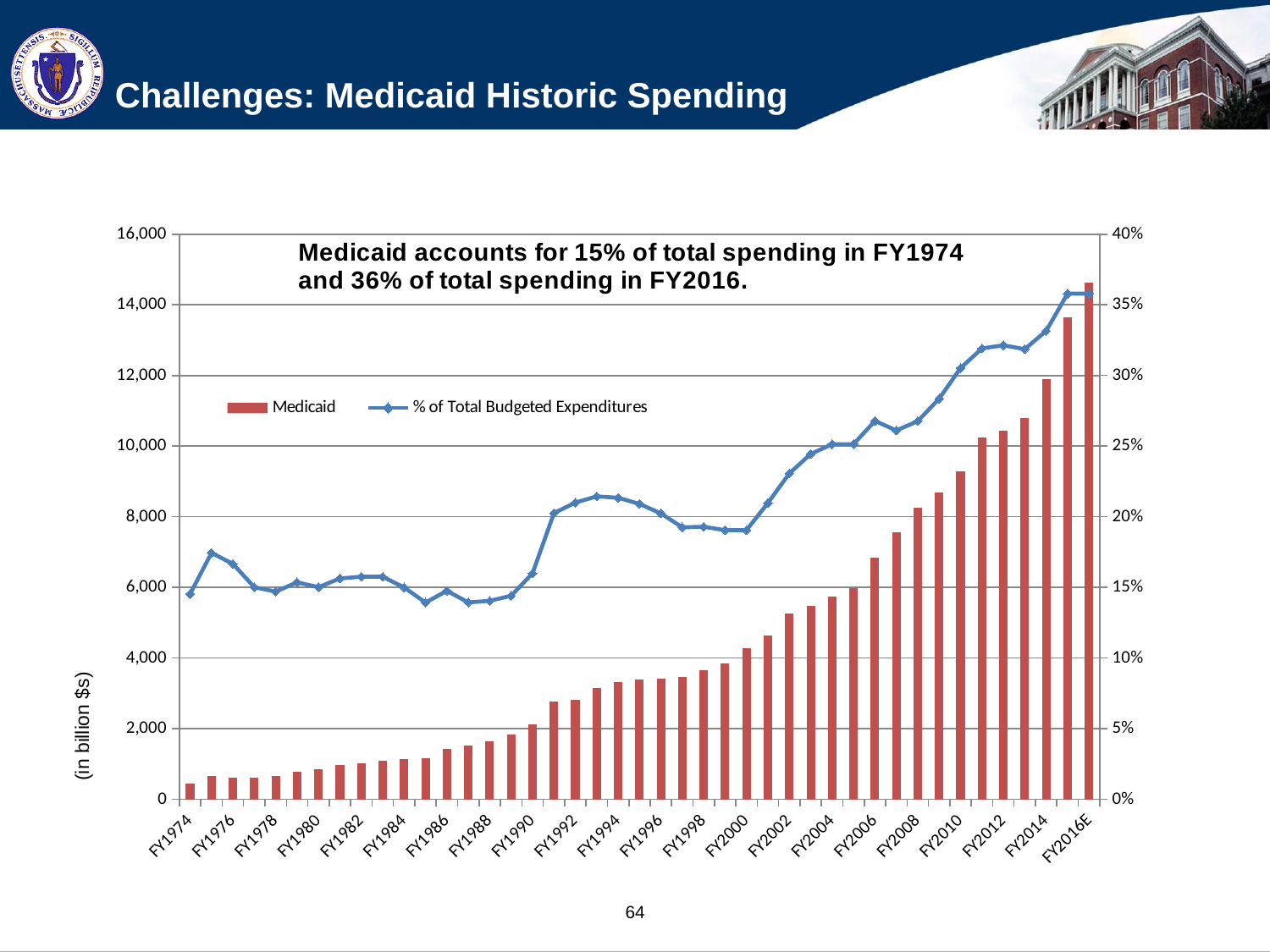
How many series does the chart legend list? 2 Which fiscal year has the lowest Medicaid spending bar? FY1974 What share of total spending does Medicaid account for in FY2016? 36% Is the Medicaid spending bar for FY2010 greater or less than 10,000? less Which is larger, the Medicaid spending bar for FY2008 or for FY2004? FY2008 What kind of chart is shown on the slide? A combined bar and line chart What unit label is shown on the left vertical axis? (in billion $s) Which fiscal year has the highest Medicaid spending bar? FY2016E Is the % of Total Budgeted Expenditures for FY2012 greater or less than 30%? greater What share of total spending did Medicaid account for in FY1974? 15% Do the Medicaid spending bars generally rise or fall from FY1974 to FY2016E? Rise Is the Medicaid spending bar for FY2016E greater or less than 14,000? greater